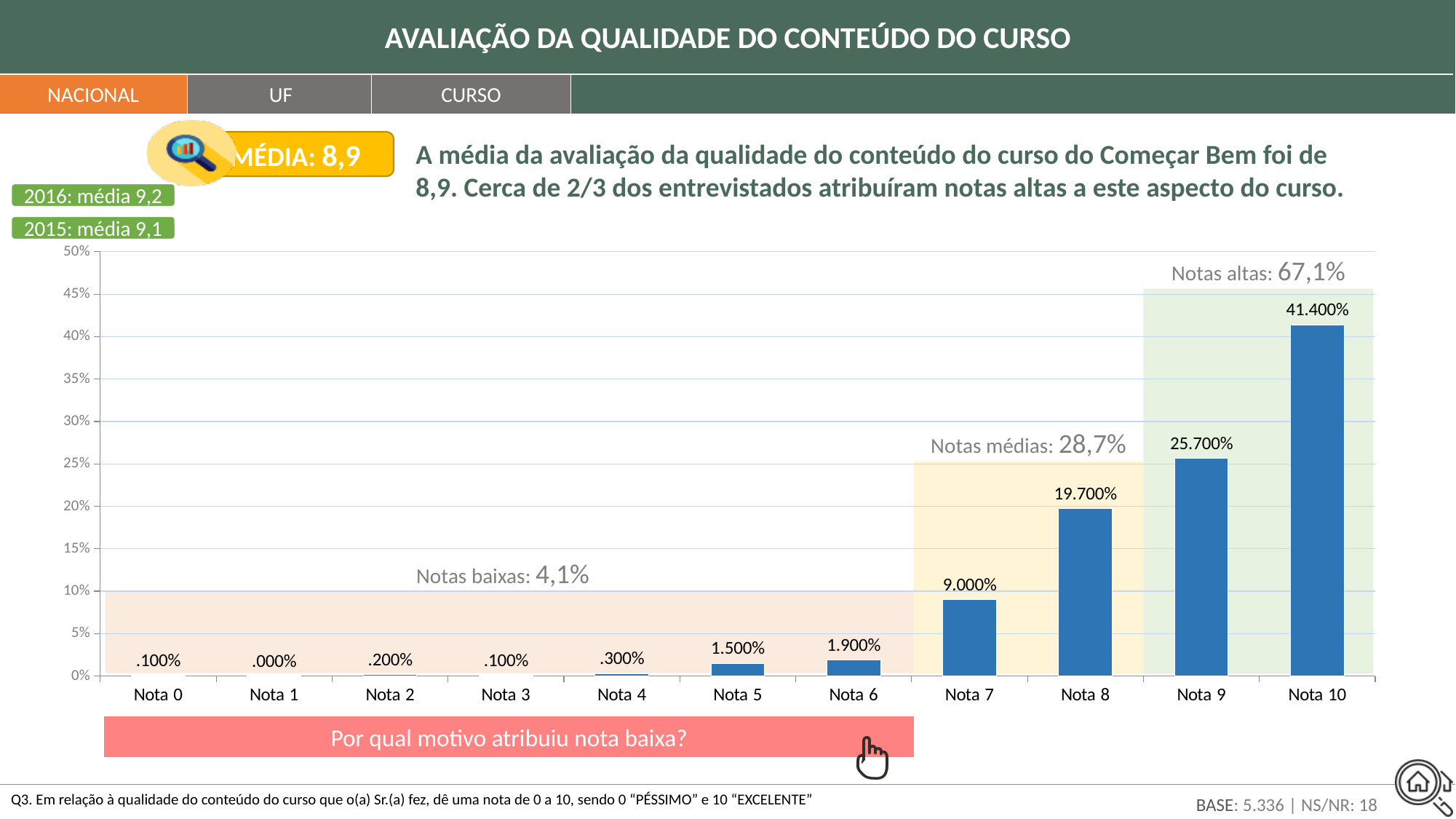
What is the value for Nota 10? 41.400% Do the values generally rise or fall from Nota 6 to Nota 10? rise Which category has the lowest value? Nota 1 What is the value for Nota 5? 1.500% What percentage is shown for 'Notas altas' on the chart? 67,1% Is the value for Nota 9 greater or less than 20%? greater Which is larger, the value for Nota 7 or the value for Nota 8? Nota 8 What is the difference between the values for Nota 10 and Nota 9? 15.700% Which category has the highest value? Nota 10 What kind of chart is shown on the slide? bar chart How many categories are shown on the x axis? 11 What is the value for Nota 8? 19.700%